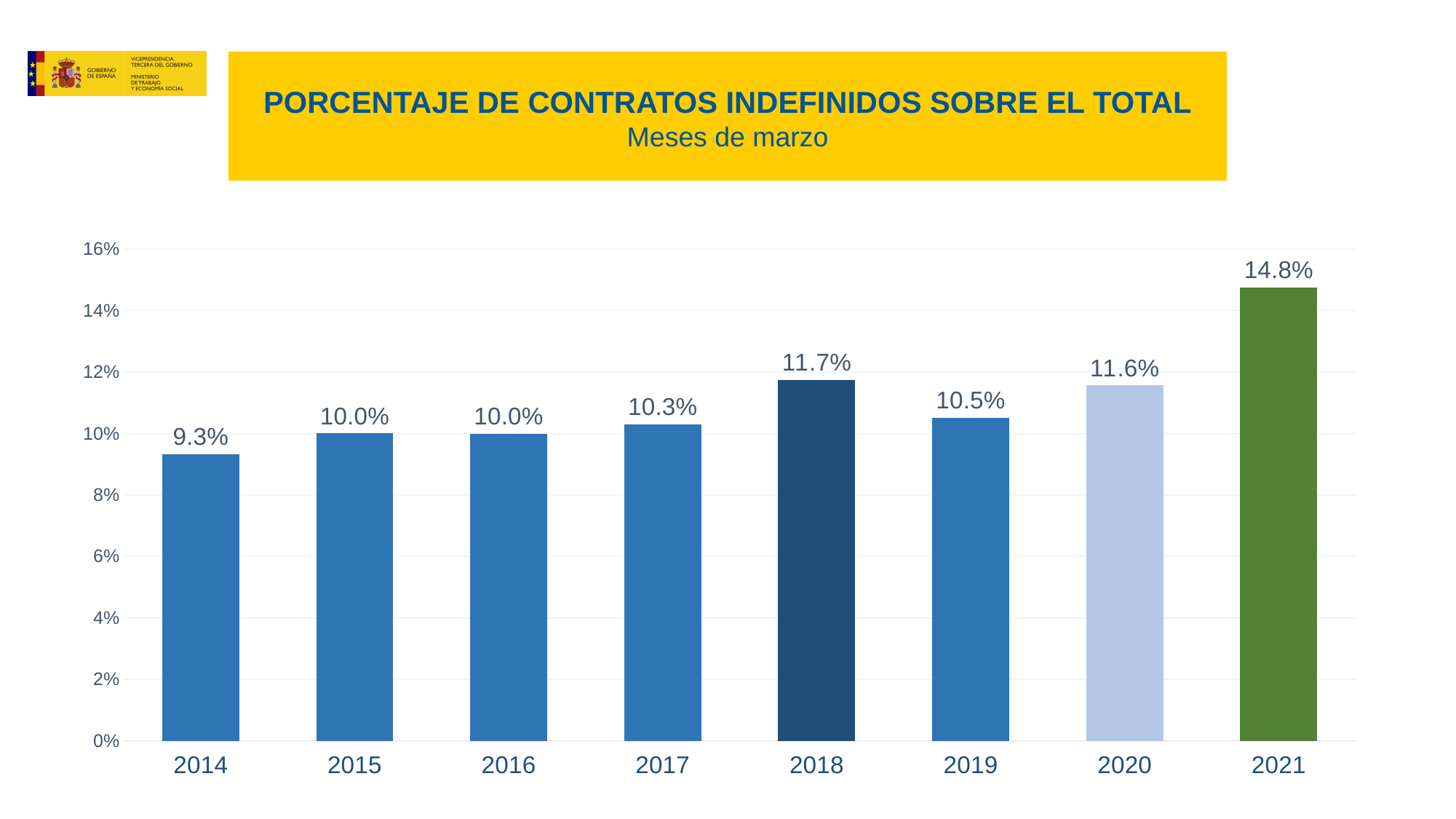
What is the value for 2018? 11.7% What is the subtitle shown under the chart title? Meses de marzo What is the value for 2021? 14.8% Is the value for 2021 greater or less than 14%? greater What is the value for 2014? 9.3% What is the difference between the values for 2018 and 2014? 2.4% How many years are shown on the x axis? 8 Which is larger, the value for 2019 or the value for 2017? 2019 What kind of chart is this? bar chart What is the difference between the values for 2021 and 2020? 3.2% Which year has the lowest value? 2014 Which year has the highest value? 2021